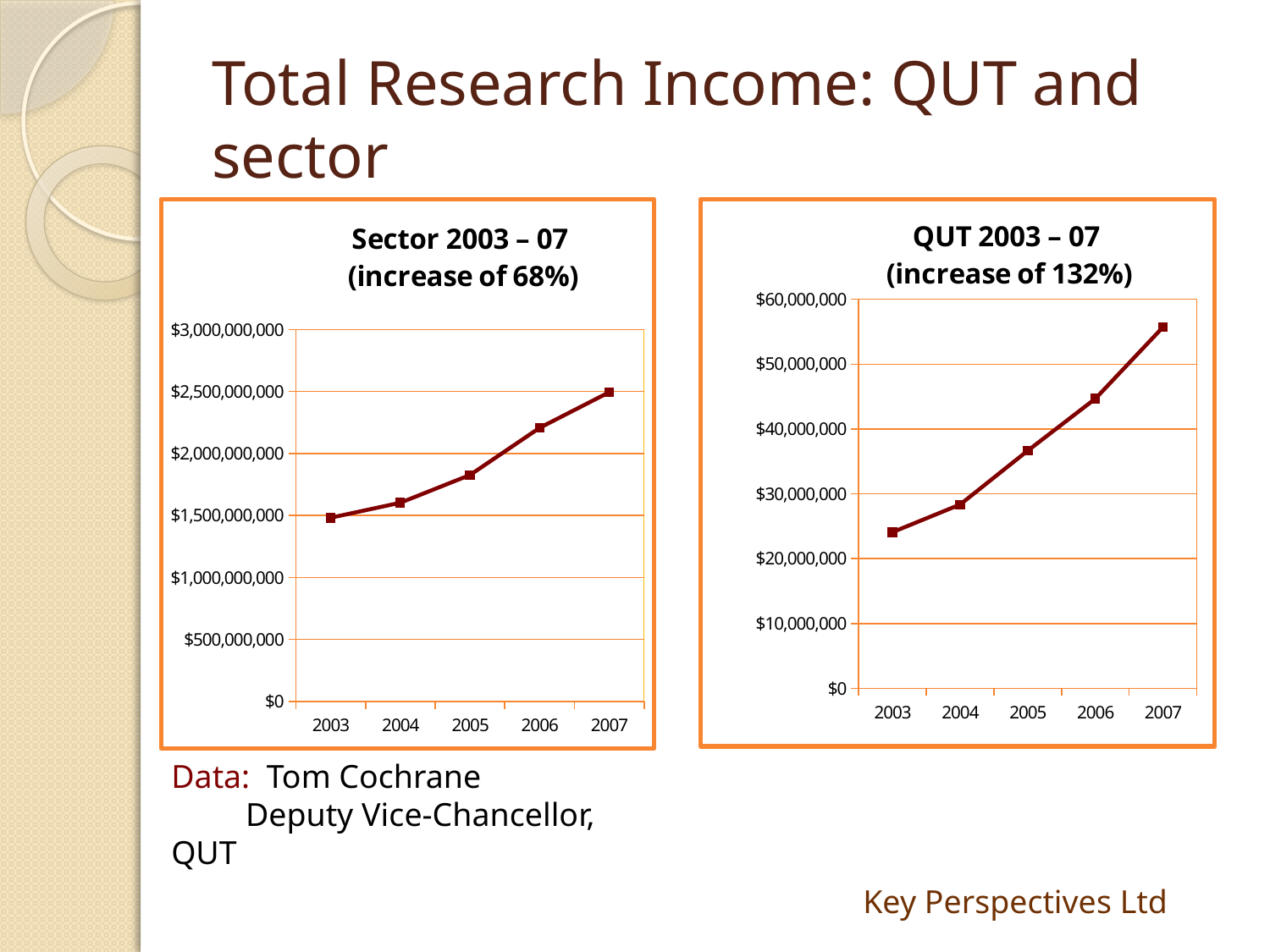
What kind of chart is the 'Sector 2003 – 07' chart on the left? line chart In the 'Sector 2003 – 07' chart, is the value for 2003 greater or less than $2,000,000,000? less According to the chart titles, what percentage increase is shown for QUT from 2003 to 2007? 132% In the 'Sector 2003 – 07' chart, which year has the lowest value? 2003 In the 'QUT 2003 – 07' chart, which year has the highest value? 2007 In the 'Sector 2003 – 07' chart, how many years are plotted on the x axis? 5 What kind of chart is the 'QUT 2003 – 07' chart on the right? line chart In the 'QUT 2003 – 07' chart, is the value for 2007 greater or less than $50,000,000? greater In the 'Sector 2003 – 07' chart, is the value for 2006 greater or less than $2,000,000,000? greater In the 'QUT 2003 – 07' chart, do the values rise or fall from 2003 to 2007? rise In the 'QUT 2003 – 07' chart, which year has the larger value, 2004 or 2006? 2006